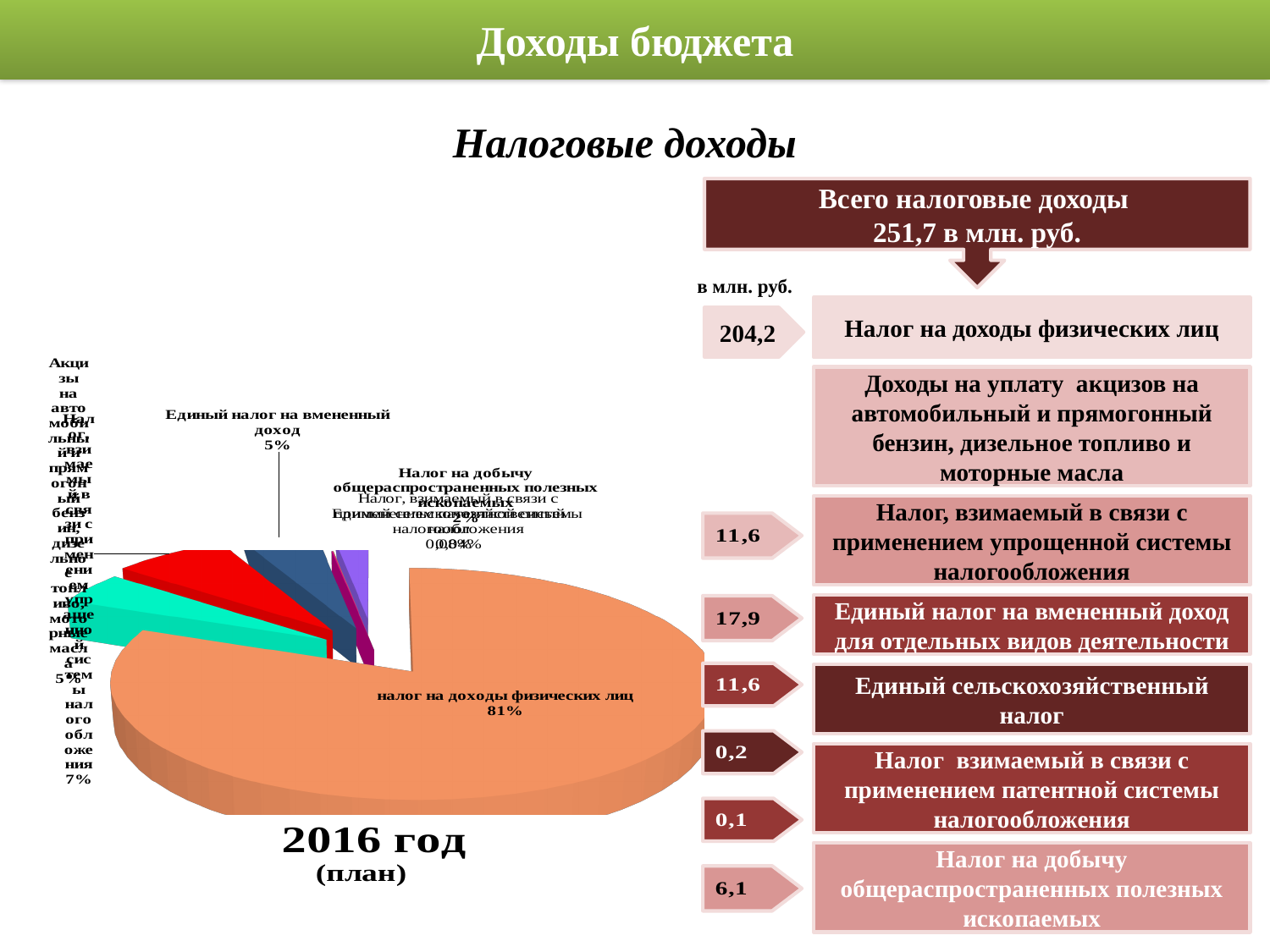
What share of the pie does "налог на доходы физических лиц" have? 81% What kind of chart is shown on the slide? pie chart What is the title printed below the pie chart? 2016 год (план) What colour is the largest slice of the pie chart? orange Which slice is larger: "Единый налог на вмененный доход" or "Налог на добычу общераспространенных полезных ископаемых"? Единый налог на вмененный доход By how many percentage points does the share of "Единый налог на вмененный доход" exceed the share of "Налог на добычу общераспространенных полезных ископаемых"? 3 Which category has the largest slice of the pie? налог на доходы физических лиц Which slice is larger: "налог на доходы физических лиц" or "Единый налог на вмененный доход"? налог на доходы физических лиц By how many percentage points does the share of "налог на доходы физических лиц" exceed the share of "Единый налог на вмененный доход"? 76 What share of the pie does "Единый налог на вмененный доход" have? 5% What share of the pie does "Налог на добычу общераспространенных полезных ископаемых" have? 2%